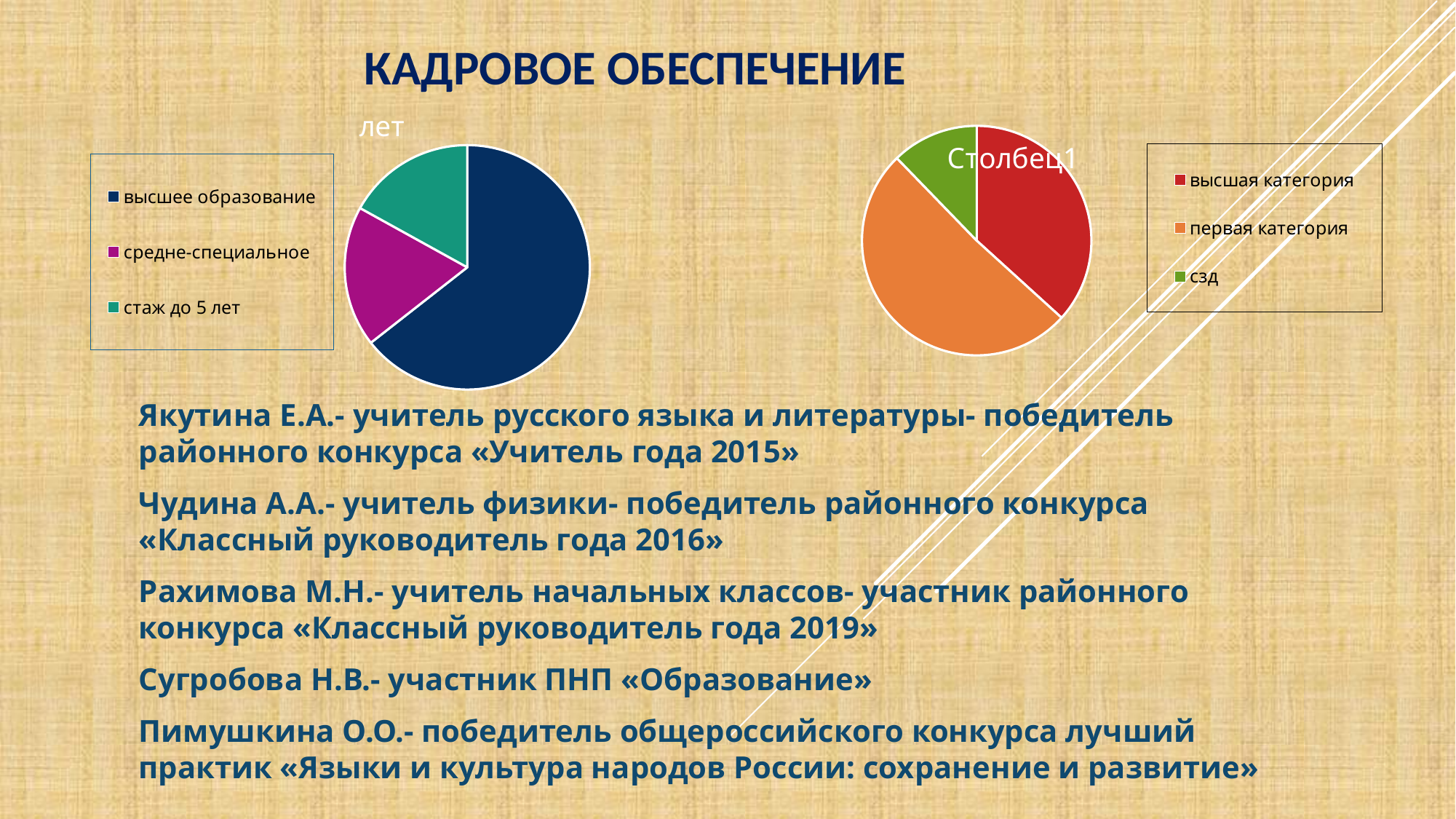
What colour is the slice for "сзд" in the right pie chart? green In the left pie chart, which category has the largest slice? высшее образование What kind of chart is the right chart titled "Столбец1"? pie chart In the left pie chart, how many slices are there? 3 How many entries does the legend of the right pie chart titled "Столбец1" list? 3 In the right pie chart titled "Столбец1", which slice is larger: высшая категория or сзд? высшая категория What kind of chart is the left chart on the slide? pie chart In the right pie chart titled "Столбец1", which category has the smallest slice? сзд In the left pie chart, which slice is larger: высшее образование or средне-специальное? высшее образование How many entries does the legend of the left pie chart list? 3 In the right pie chart titled "Столбец1", how many slices are there? 3 In the right pie chart titled "Столбец1", which category has the largest slice? первая категория